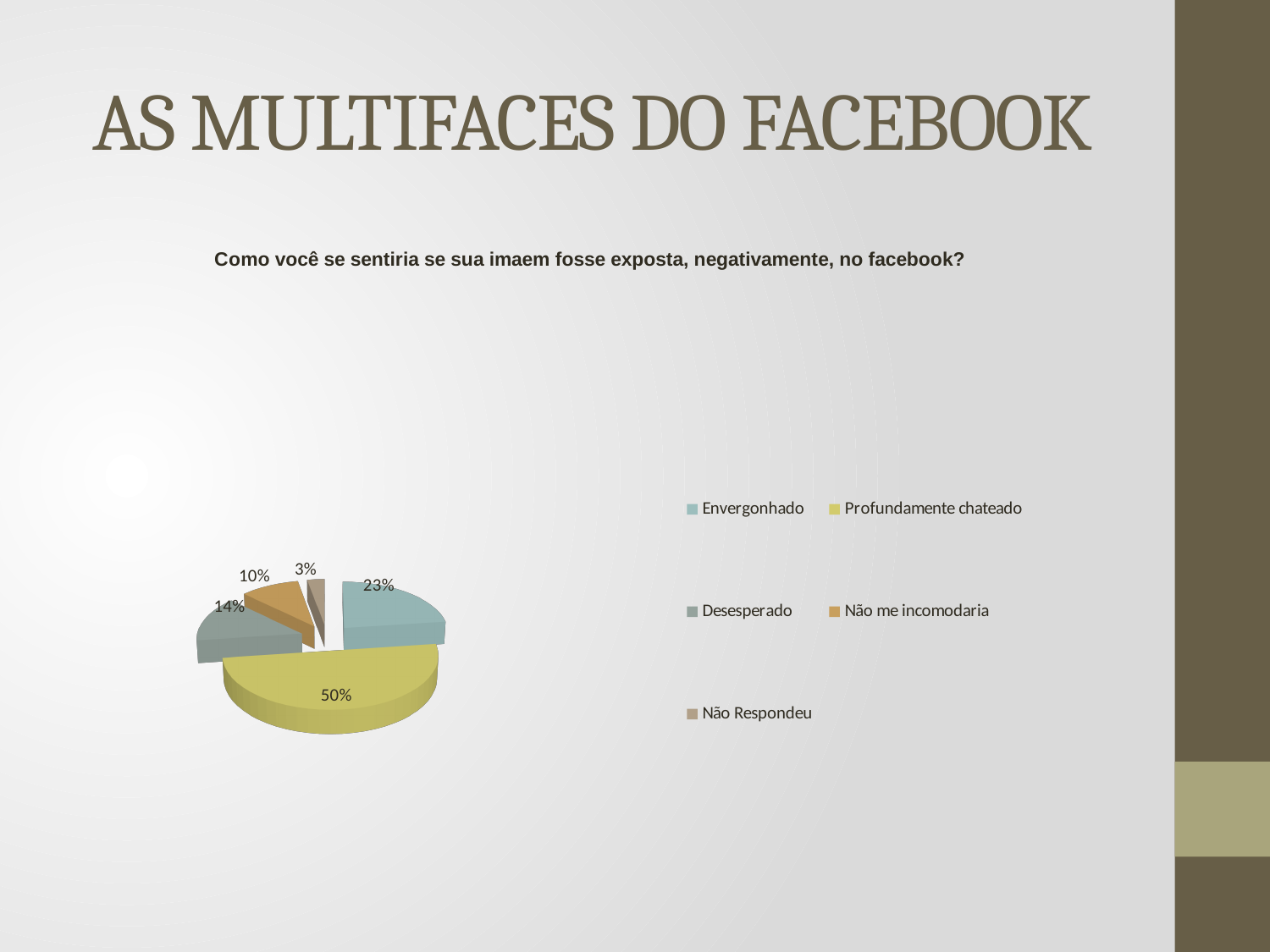
Which is larger, the value for "Desesperado" or the value for "Não me incomodaria"? Desesperado What share of the pie does "Profundamente chateado" represent? 50% What kind of chart is shown on the slide? Pie chart Which category has the largest slice of the pie? Profundamente chateado How many categories does the legend list? 5 What is the value for "Envergonhado"? 23% What is the value for "Não me incomodaria"? 10% Which category has the smallest slice of the pie? Não Respondeu What is the value for "Não Respondeu"? 3% What is the title of the chart? Como você se sentiria se sua imaem fosse exposta, negativamente, no facebook? What is the difference between the values for "Profundamente chateado" and "Envergonhado"? 27% What is the value for "Desesperado"? 14%